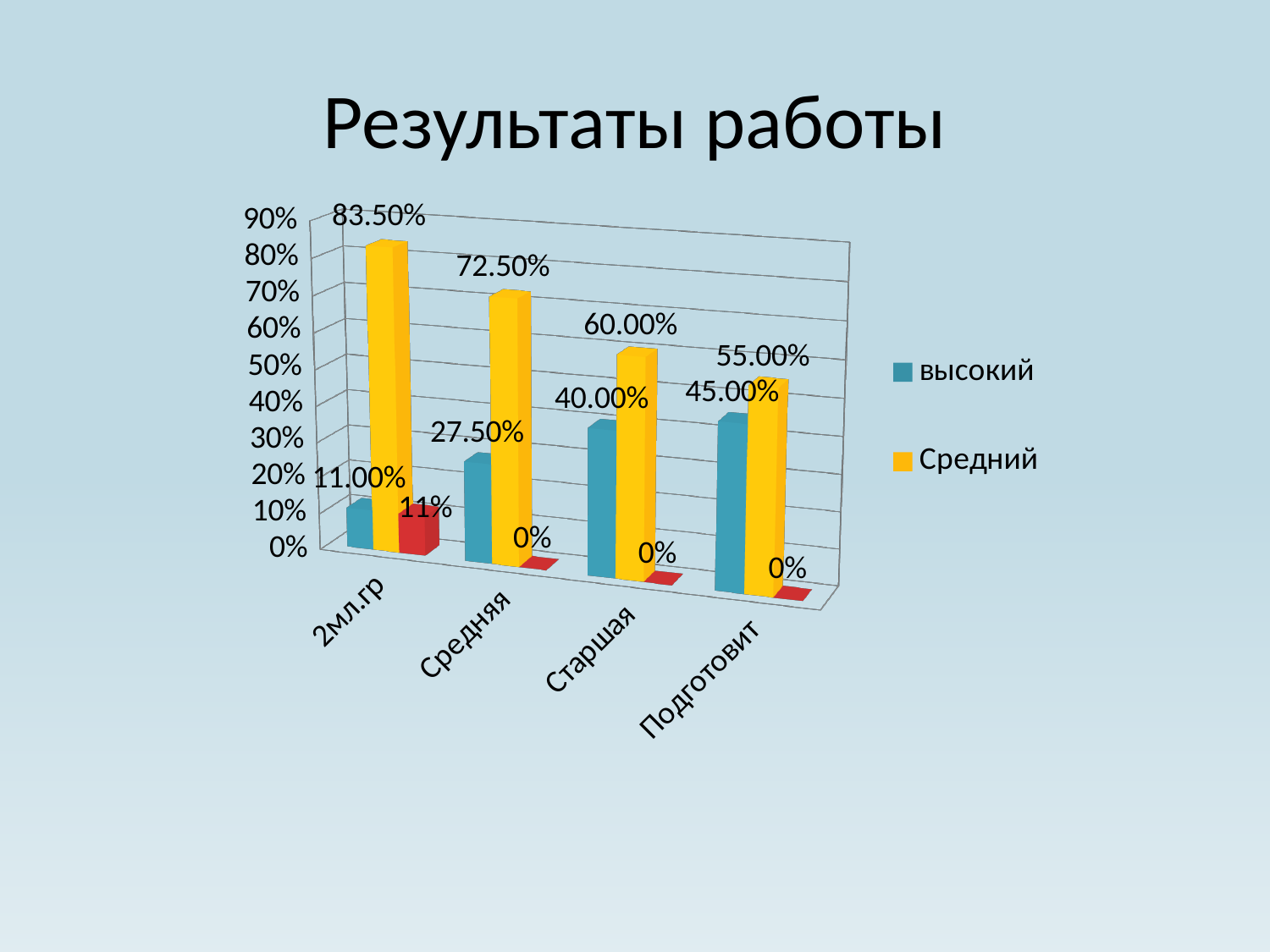
Which category has the highest value in the Средний series? 2мл.гр Which category has the lowest value in the высокий series? 2мл.гр What kind of chart is shown on the slide? Bar chart Do the values of the Средний series rise or fall from 2мл.гр to Подготовит? Fall How many categories are shown on the x axis? 4 How many series does the legend list? 2 What is the value of the высокий series for Старшая? 40.00% What is the difference between the Средний and высокий values for Подготовит? 10.00% What is the value of the Средний series for Средняя? 72.50% Which is larger for Старшая: the высокий value or the Средний value? Средний What is the value of the высокий series for Подготовит? 45.00% What is the value of the Средний series for 2мл.гр? 83.50%